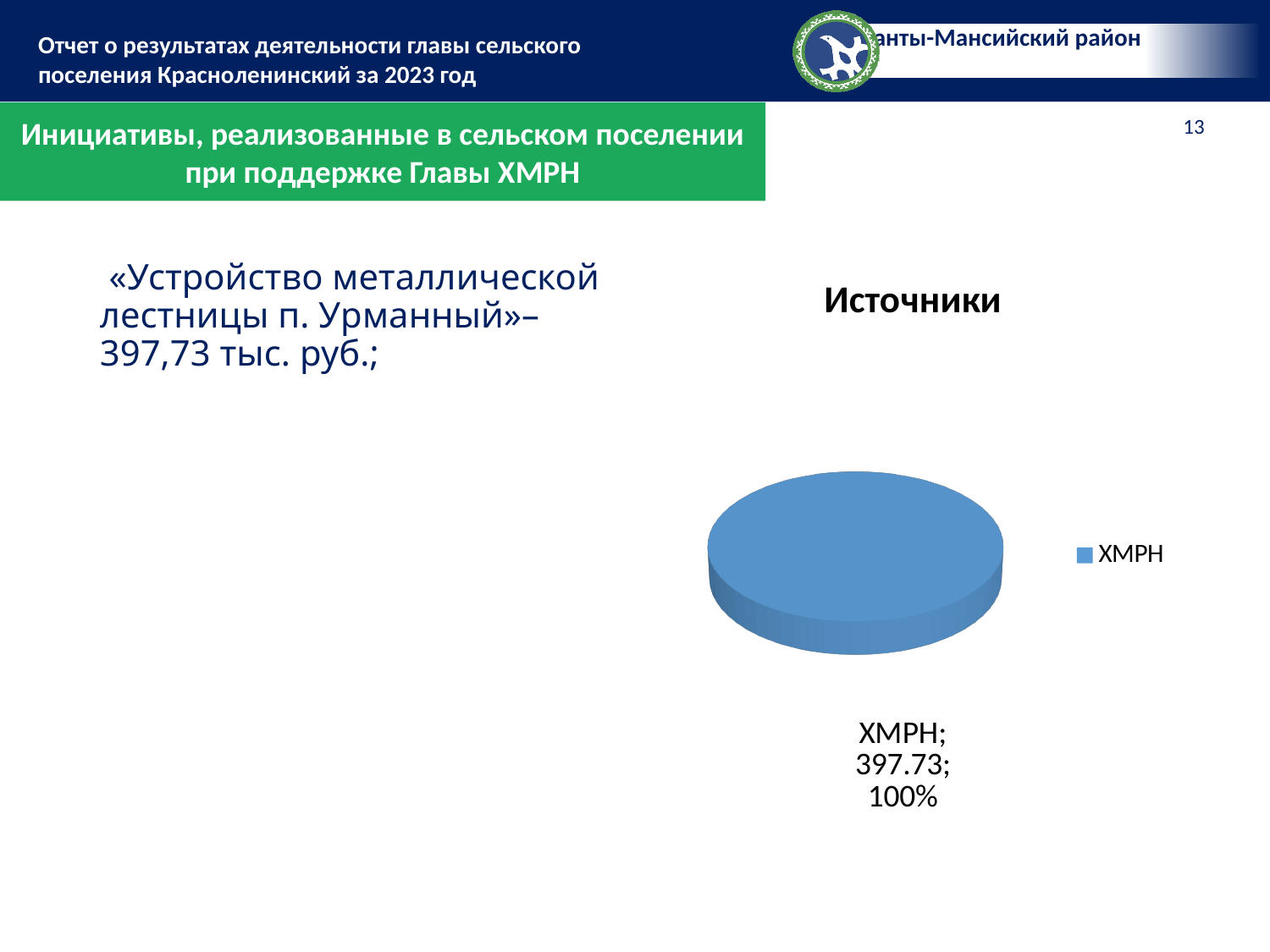
What value is shown for ХМРН in the pie chart? 397.73 How many slices does the pie chart have? 1 Which category is shown in the legend of the pie chart? ХМРН What is the title of the chart? Источники What share of the pie does ХМРН represent? 100% How many entries does the legend list? 1 Which category has the largest slice in the pie chart? ХМРН What kind of chart is shown on the slide? pie chart